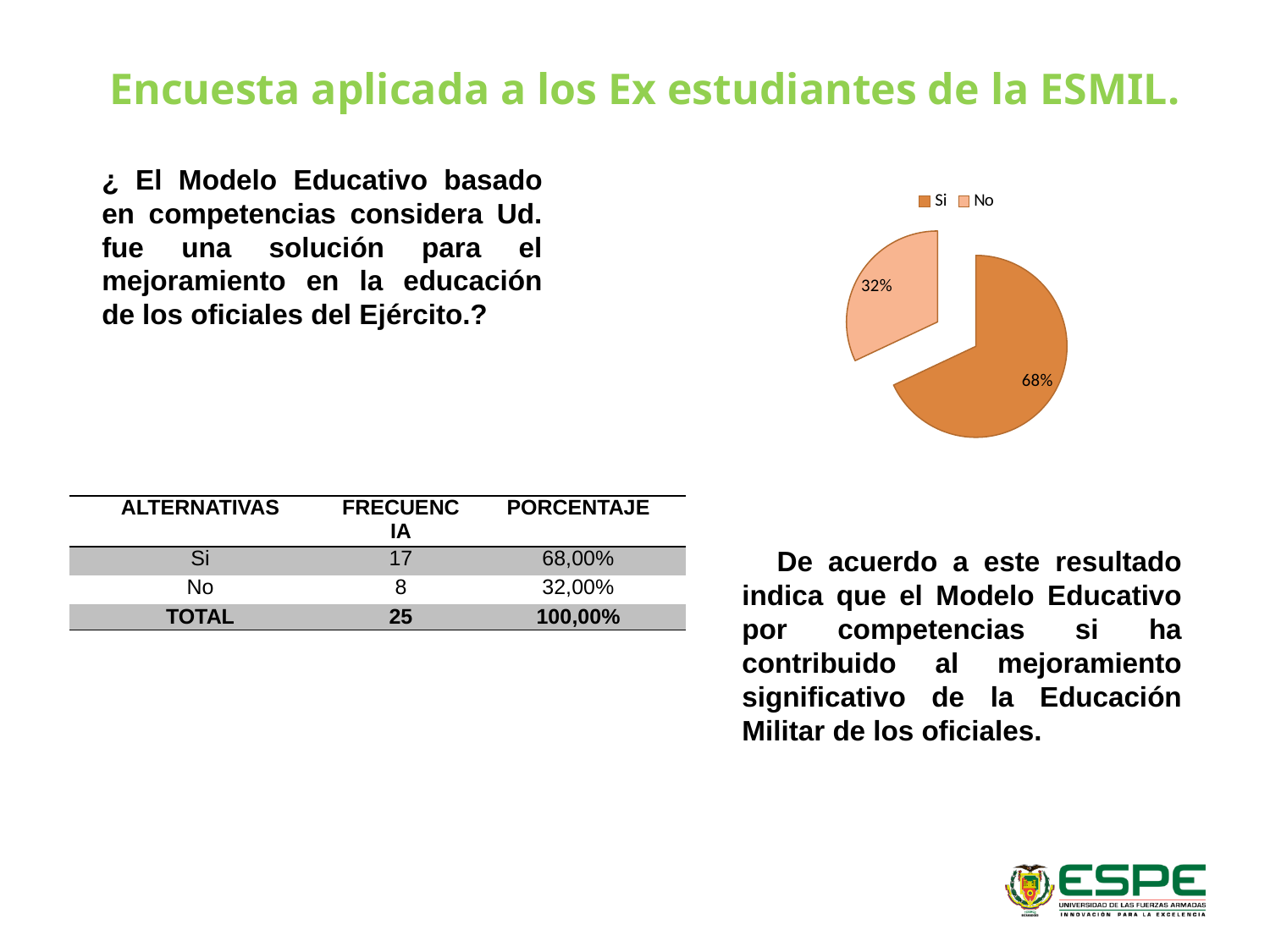
Which slice of the pie chart is the smallest? No How many entries does the legend of the pie chart list? 2 What percentage of the pie chart is labelled for "Si"? 68% Which slice is larger in the pie chart, "Si" or "No"? Si What kind of chart is shown on the slide? pie chart What is the difference in percentage points between the "Si" and "No" slices of the pie chart? 36 How many slices does the pie chart have? 2 Which slice of the pie chart is drawn in the darker orange colour? Si What percentage of the pie chart is labelled for "No"? 32% Which slice of the pie chart is the largest? Si What share of the pie chart does the "No" slice represent? 32% What are the two legend entries of the pie chart? Si and No